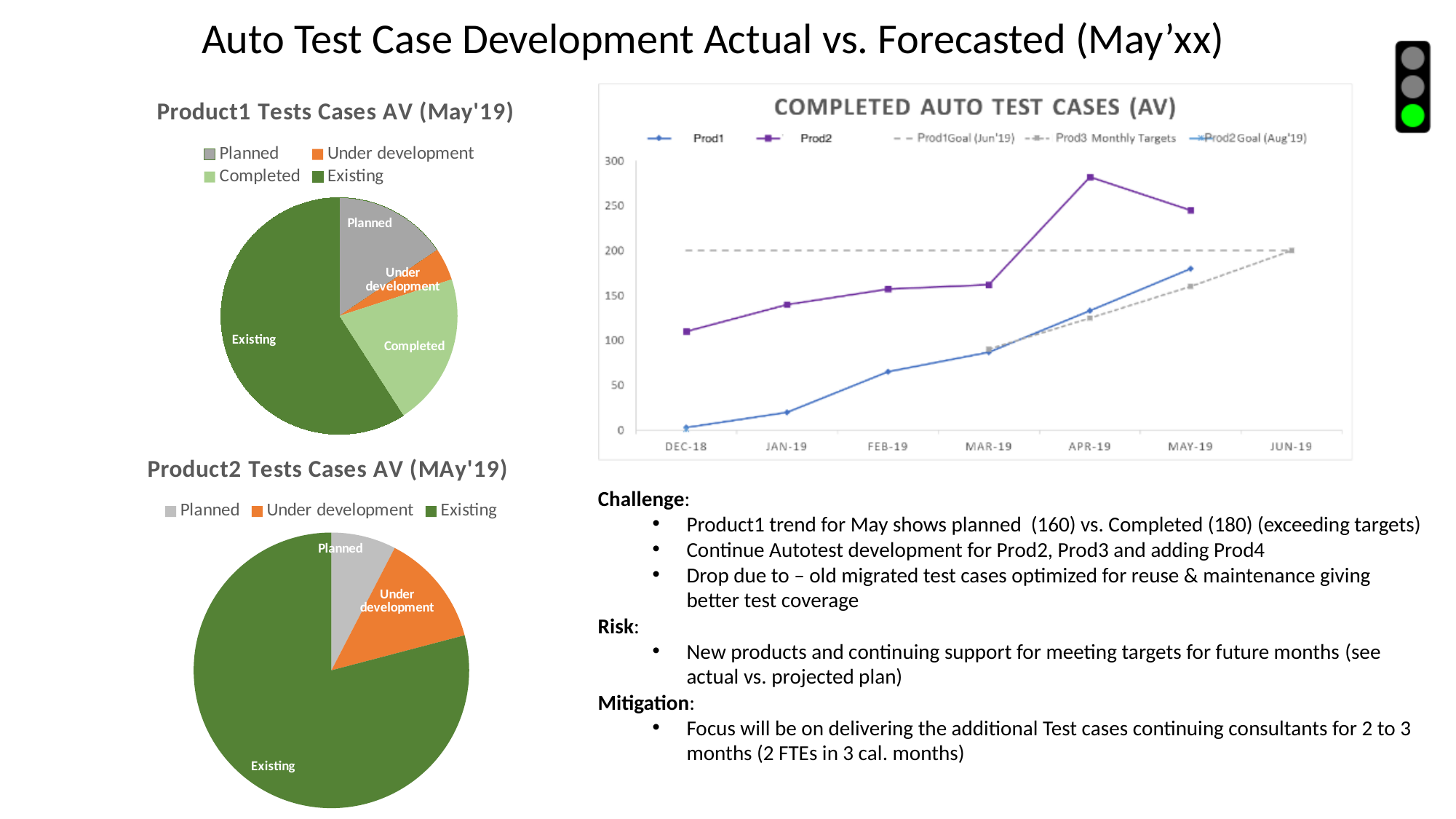
In the 'Product1 Tests Cases AV (May'19)' pie chart, which category has the smallest slice? Under development How many series does the legend of the 'COMPLETED AUTO TEST CASES (AV)' chart list? 5 In the 'Product1 Tests Cases AV (May'19)' pie chart, which category has the largest slice? Existing What kind of chart is the 'COMPLETED AUTO TEST CASES (AV)' chart? Line chart In the 'COMPLETED AUTO TEST CASES (AV)' chart, is the Prod1 value for DEC-18 greater or less than 50? less In the 'COMPLETED AUTO TEST CASES (AV)' chart, is the Prod2 value for APR-19 greater or less than 250? greater In the 'COMPLETED AUTO TEST CASES (AV)' chart, in which month does Prod2 reach its highest value? APR-19 What kind of chart is the 'Product1 Tests Cases AV (May'19)' chart? Pie chart In the 'Product2 Tests Cases AV (MAy'19)' pie chart, which category has the smallest slice? Planned In the 'COMPLETED AUTO TEST CASES (AV)' chart, which series is higher in MAY-19, Prod1 or Prod2? Prod2 How many months are shown on the x axis of the 'COMPLETED AUTO TEST CASES (AV)' chart? 7 How many slices does the 'Product2 Tests Cases AV (MAy'19)' pie chart have? 3